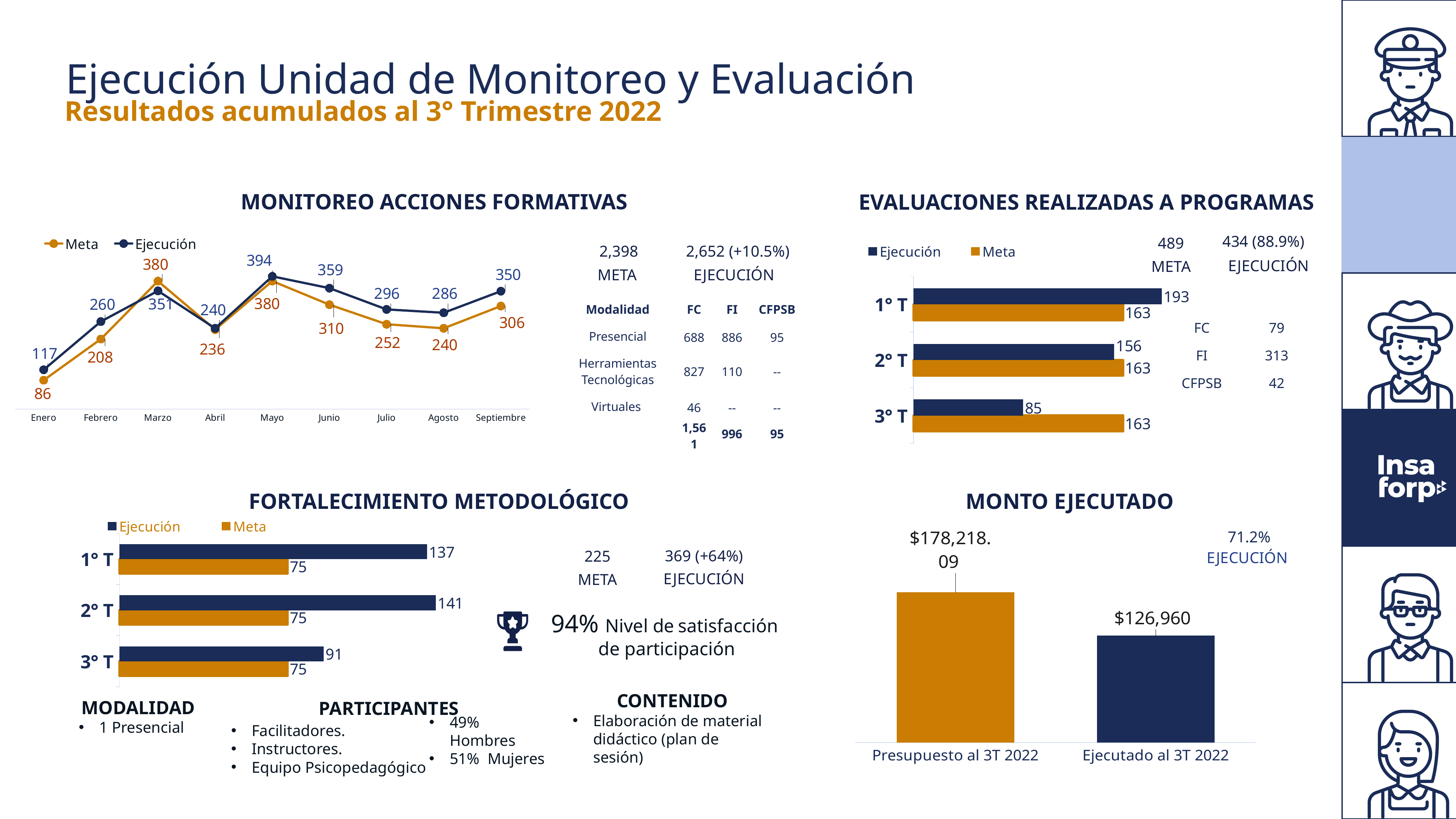
In the MONITOREO ACCIONES FORMATIVAS chart, what is the difference between Ejecución and Meta in Septiembre? 44 In the MONITOREO ACCIONES FORMATIVAS chart, which month has the lowest Ejecución value? Enero In the FORTALECIMIENTO METODOLÓGICO chart, what is the difference between Ejecución and Meta for 1° T? 62 In the EVALUACIONES REALIZADAS A PROGRAMAS chart, what is the Ejecución value for 3° T? 85 In the MONITOREO ACCIONES FORMATIVAS chart, what is the Meta value for Enero? 86 In the EVALUACIONES REALIZADAS A PROGRAMAS chart, which quarter has the highest Ejecución value? 1° T In the FORTALECIMIENTO METODOLÓGICO chart, what is the Ejecución value for 2° T? 141 In the MONITOREO ACCIONES FORMATIVAS chart, how many months are plotted on the x axis? 9 In the MONTO EJECUTADO chart, what is the value for Ejecutado al 3T 2022? $126,960 What type of chart is MONITOREO ACCIONES FORMATIVAS? Line chart In the EVALUACIONES REALIZADAS A PROGRAMAS chart, is Ejecución or Meta larger for 2° T? Meta In the MONITOREO ACCIONES FORMATIVAS chart, what is the Ejecución value for Mayo? 394